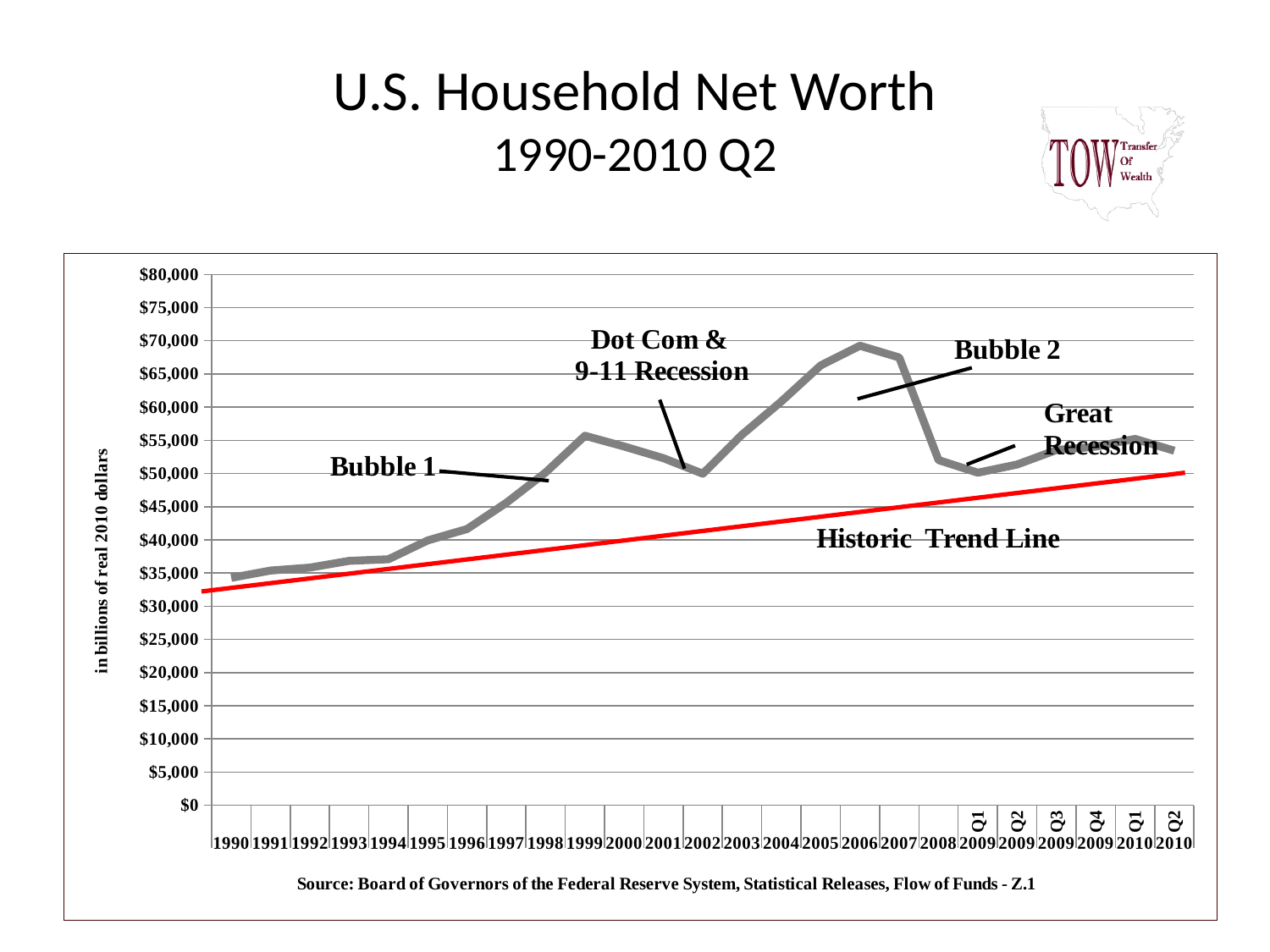
Which point on the x axis has the lowest household net worth? 1990 Is the value for 2001 greater or less than $50,000? greater Which is larger, the value for 1990 or the value for Q2 2010? Q2 2010 What is the label on the y axis? in billions of real 2010 dollars Is the value for 2006 greater or less than $65,000? greater Which is larger, the value for 2006 or the value for 1999? 2006 Which year has the highest household net worth on the chart? 2006 How many points are labelled along the x axis? 25 Does household net worth rise or fall from 1990 to 1999? rise What kind of chart is shown on the slide? line chart